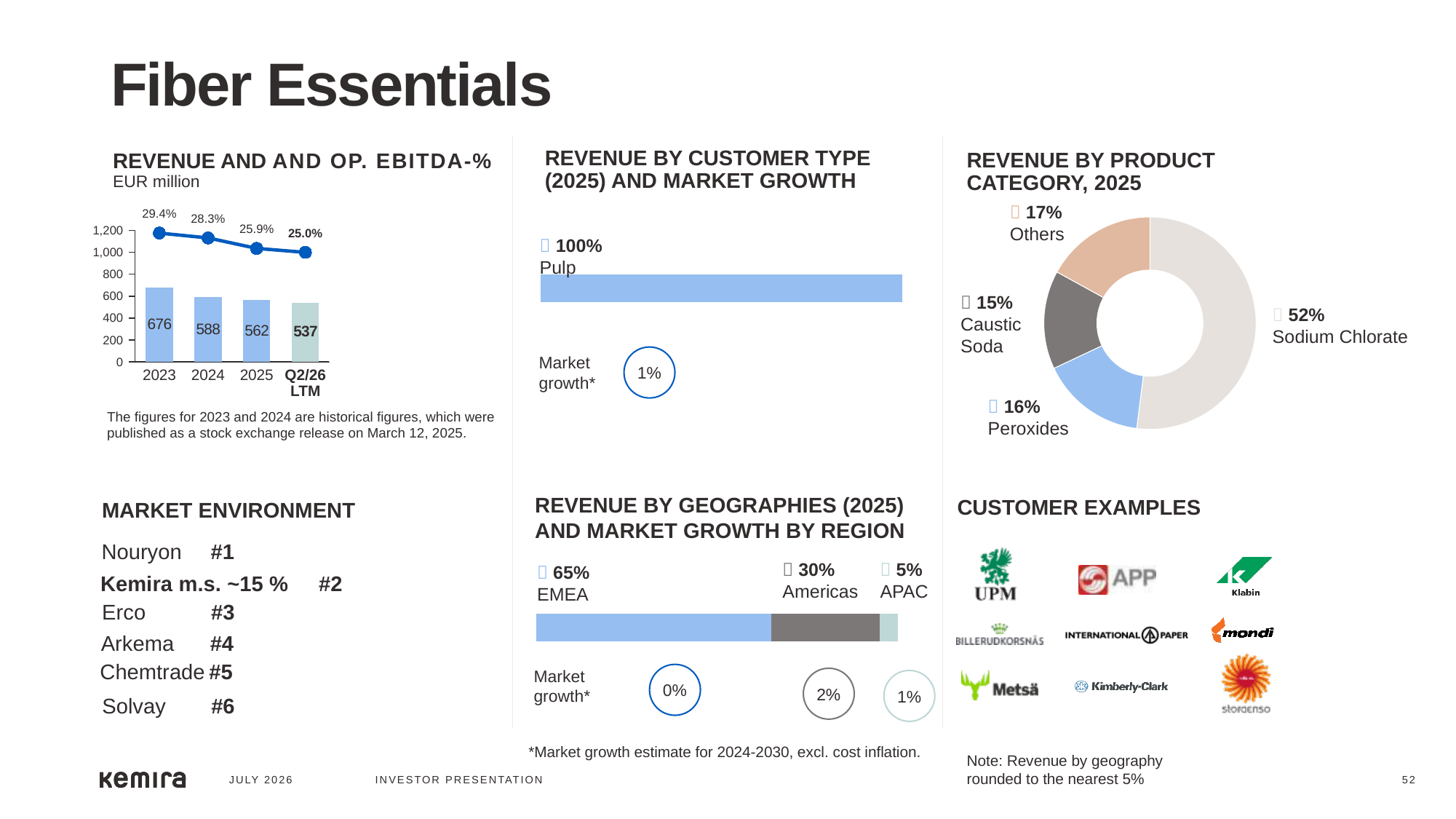
In the 'Revenue and Op. EBITDA-%' chart, does the Op. EBITDA-% rise or fall from 2023 to Q2/26 LTM? Fall What kind of chart is 'Revenue by product category, 2025'? Donut (pie) chart In the 'Revenue and Op. EBITDA-%' chart, what is the revenue for Q2/26 LTM? 537 In the 'Revenue and Op. EBITDA-%' chart, what is the difference in revenue between 2023 and 2024? 88 In the 'Revenue by product category, 2025' chart, which category has the smallest share? Caustic Soda In the 'Revenue by geographies (2025)' chart, what share of revenue comes from EMEA? 65% In the 'Revenue and Op. EBITDA-%' chart, what is the Op. EBITDA-% for 2025? 25.9% In the 'Revenue by product category, 2025' chart, what share does Sodium Chlorate have? 52% In the 'Revenue and Op. EBITDA-%' chart, which year has the highest revenue? 2023 In the 'Revenue by geographies (2025)' chart, what is the market growth estimate for the Americas? 2% In the 'Revenue and Op. EBITDA-%' chart, how many periods are shown on the x axis? 4 In the 'Revenue and Op. EBITDA-%' chart, what was revenue in 2023? 676